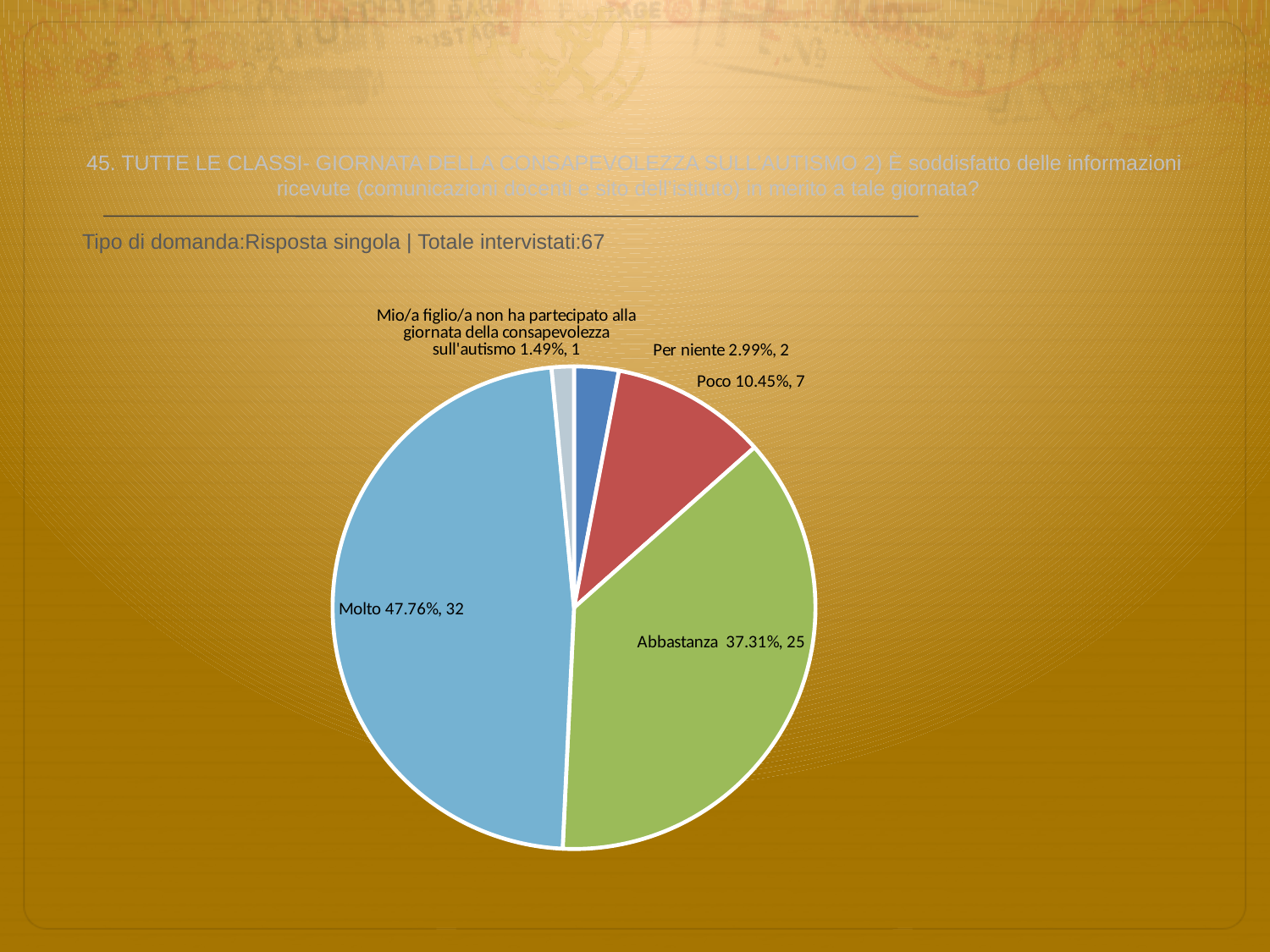
What colour is the 'Abbastanza' slice? green Which category has the largest slice of the pie? Molto What percentage share does the 'Molto' slice have? 47.76% Which has more respondents, 'Poco' or 'Per niente'? Poco How many respondents answered 'Per niente'? 2 What is the difference in respondent count between 'Molto' and 'Abbastanza'? 7 How many slices does the pie chart have? 5 What percentage share does the 'Poco' slice have? 10.45% What is the total number of respondents stated on the slide? 67 What kind of chart is shown on the slide? pie chart How many respondents answered 'Abbastanza'? 25 Which category has the smallest slice of the pie? Mio/a figlio/a non ha partecipato alla giornata della consapevolezza sull'autismo